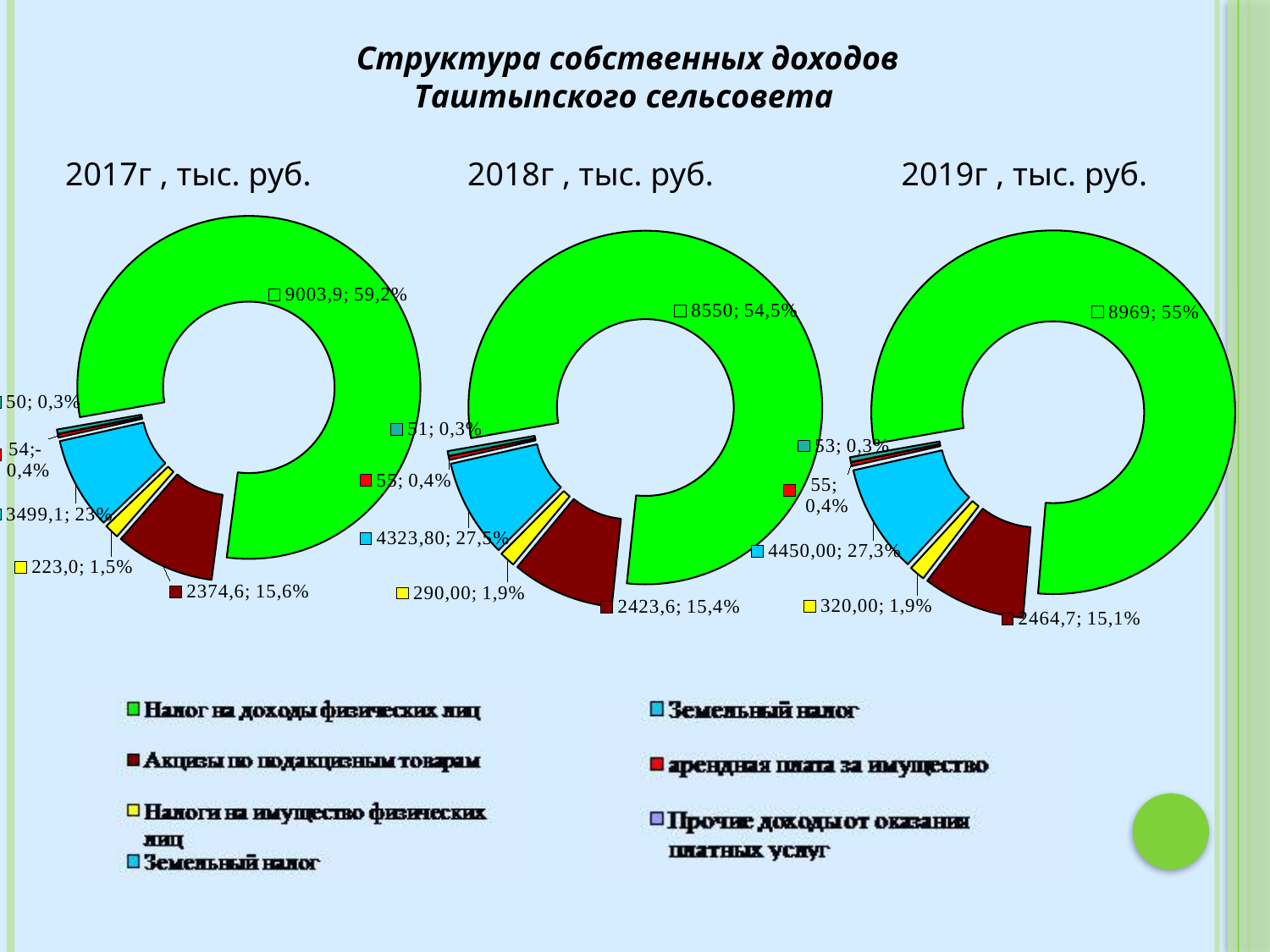
In the 2019 chart, what value is shown for Земельный налог? 4450,00; 27,3% What is the title of the slide's charts? Структура собственных доходов Таштыпского сельсовета In the 2019 chart, which category has the largest slice? Налог на доходы физических лиц How many categories does the legend list? 6 In the 2018 chart, what value is shown for Налог на доходы физических лиц? 8550; 54,5% In the 2018 chart, what value is shown for Налоги на имущество физических лиц? 290,00; 1,9% In the 2017 chart, what value is shown for Акцизы по подакцизным товарам? 2374,6; 15,6% What is the difference between the Налог на доходы физических лиц value in 2019 (8969) and in 2018 (8550)? 419 In the 2019 chart, what share does Налог на доходы физических лиц have? 55% How many slices does the 2019 chart have? 6 What kind of chart is used for each year on this slide? Pie (doughnut) chart In the 2018 chart, which is larger: Земельный налог or Акцизы по подакцизным товарам? Земельный налог